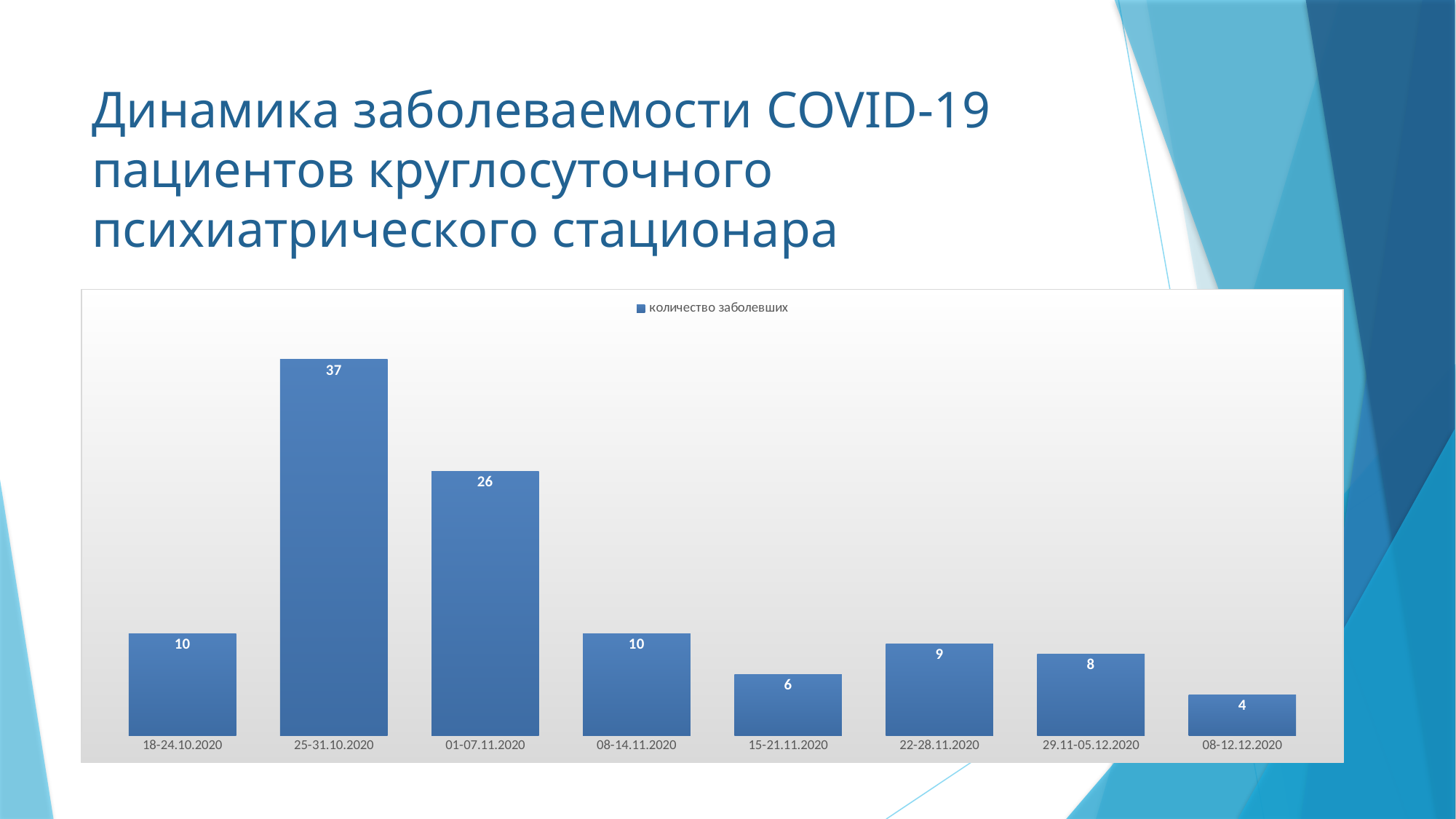
Which is larger, the value for 22-28.11.2020 or the value for 29.11-05.12.2020? 22-28.11.2020 What is the value for 01-07.11.2020? 26 What is the value for 15-21.11.2020? 6 How many periods are shown on the x axis? 8 What is the legend entry for the series? количество заболевших What is the value for 25-31.10.2020? 37 Which period has the lowest value? 08-12.12.2020 What is the difference between the values for 25-31.10.2020 and 01-07.11.2020? 11 What kind of chart is shown on the slide? bar chart Which period has the highest value? 25-31.10.2020 How many series does the legend list? 1 What is the value for 08-12.12.2020? 4